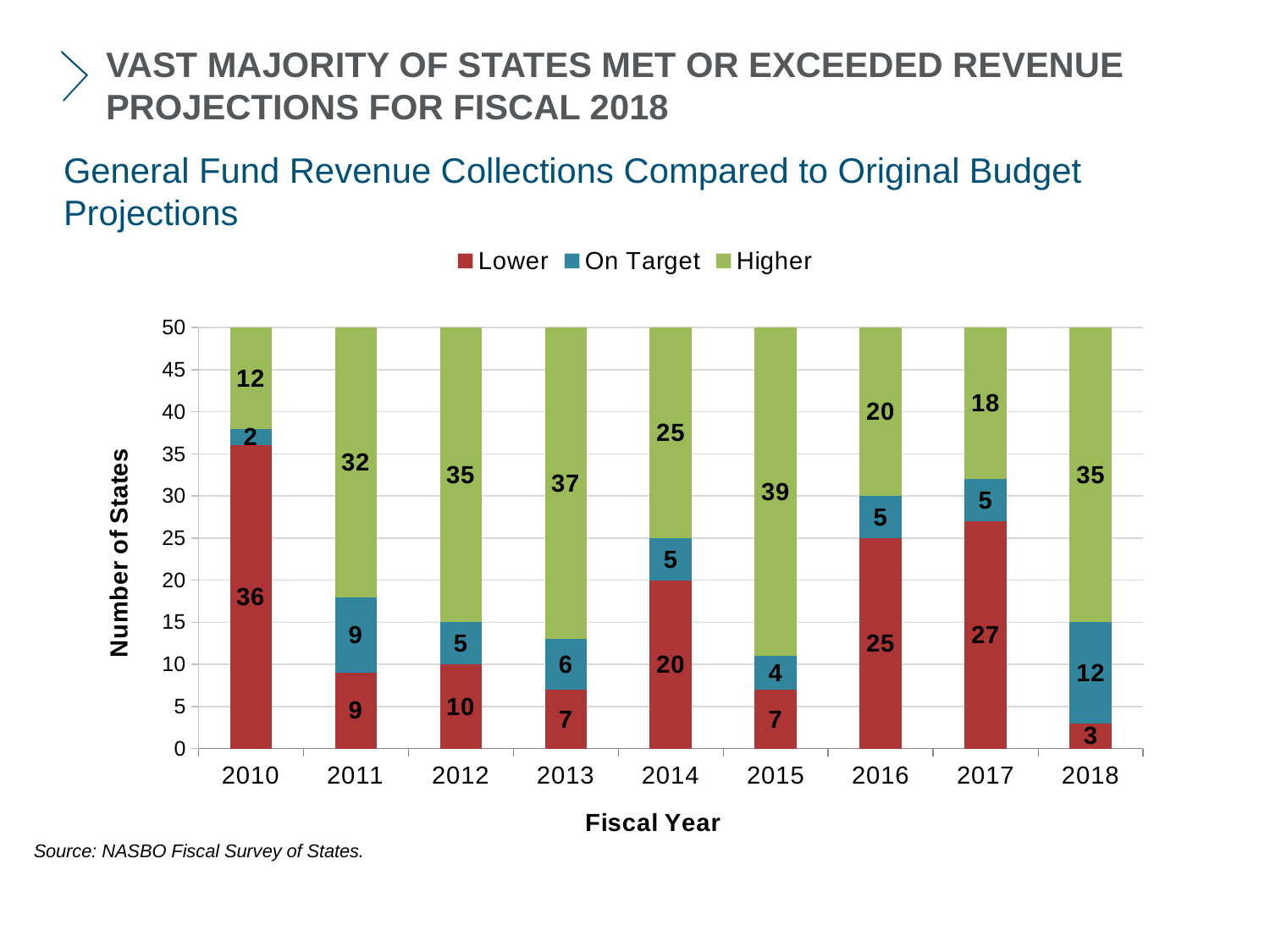
How many series does the legend list? 3 What is the On Target value for fiscal 2018? 12 What is the difference between the Lower values for fiscal 2017 and fiscal 2018? 24 Which fiscal year has the lowest Lower value? 2018 What kind of chart is shown on the slide? Stacked bar chart Which series is shown in green in the legend? Higher What is the Higher value for fiscal 2015? 39 What is the total of the stacked bar for fiscal 2013? 50 Which is larger, the Higher value for fiscal 2014 or the Higher value for fiscal 2016? 2014 Which fiscal year has the highest Higher value? 2015 How many states had revenue collections Lower than projections in fiscal 2010? 36 How many fiscal years are shown on the x axis? 9